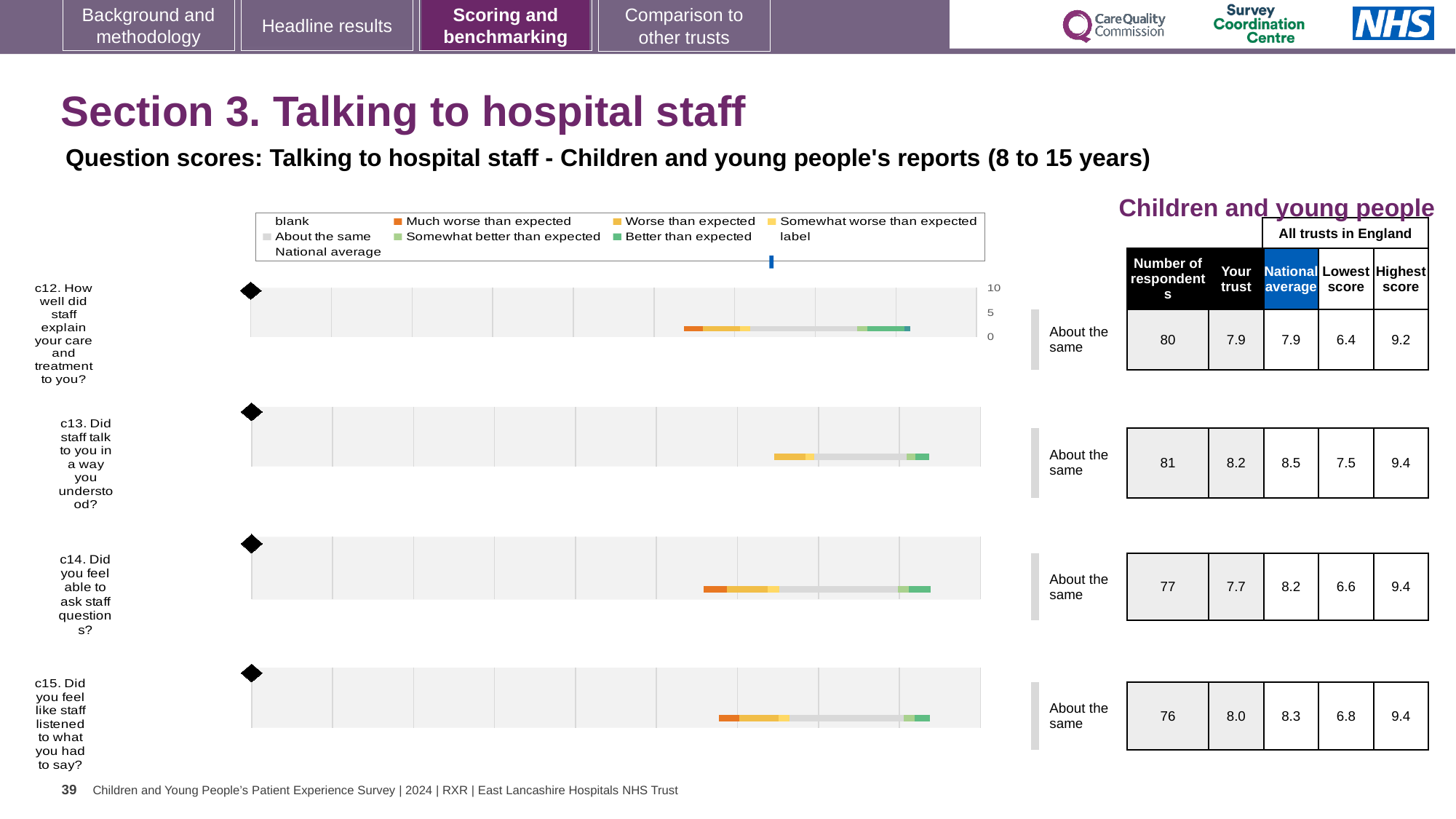
Which question has the fewest respondents? c15 What is the difference between the national average and the 'Your trust' score for c14? 0.5 How many respondents answered c12 (How well did staff explain your care and treatment to you?)? 80 For c13, which is larger: the 'Your trust' score or the national average? National average What type of chart is used to show the question scores on this slide? bar chart What is the 'Your trust' score for c13 (Did staff talk to you in a way you understood?)? 8.2 What benchmark category is shown for c12 (How well did staff explain your care and treatment to you?)? About the same Which question has the highest 'Your trust' score? c13 How many questions (c12 to c15) are plotted on this slide? 4 Which question has the lowest 'Your trust' score? c14 What is the national average score for c14 (Did you feel able to ask staff questions?)? 8.2 What is the lowest score among all trusts in England for c15 (Did you feel like staff listened to what you had to say?)? 6.8